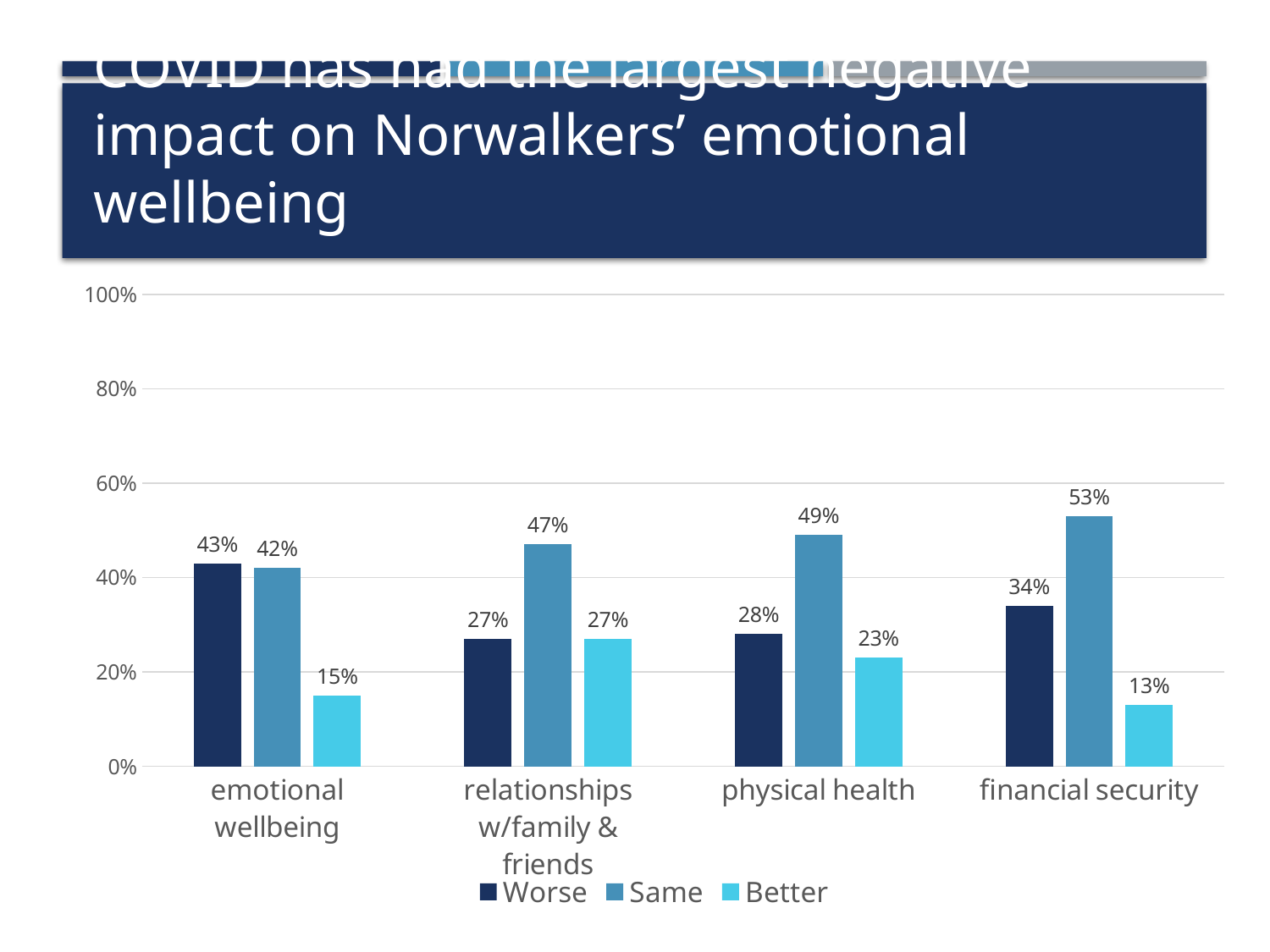
What is the difference between the 'Same' and 'Worse' values for financial security? 19% What kind of chart is shown on the slide? bar chart Is the 'Same' value for relationships w/family & friends greater or less than 40%? greater Which is larger for physical health: the 'Worse' value or the 'Same' value? Same What are the three series named in the legend? Worse, Same, Better Which category has the lowest 'Better' value? financial security How many categories are shown on the x axis? 4 What is the 'Better' value for physical health? 23% How many series does the legend list? 3 What is the 'Same' value for financial security? 53% Which category has the highest 'Worse' value? emotional wellbeing What percentage of Norwalkers said their emotional wellbeing is worse? 43%